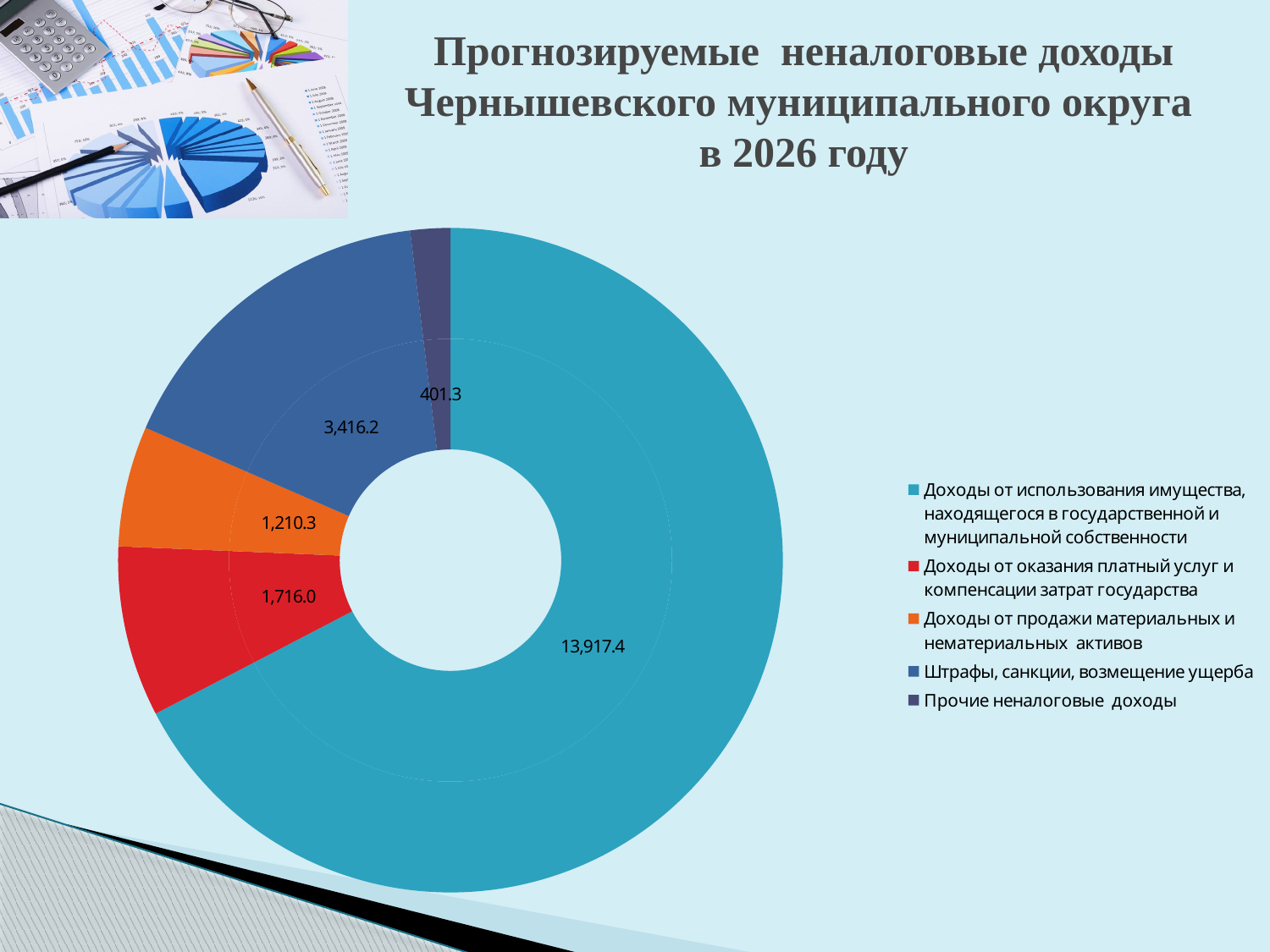
How many categories does the chart show? 5 Which is larger: «Штрафы, санкции, возмещение ущерба» or «Доходы от продажи материальных и нематериальных активов»? Штрафы, санкции, возмещение ущерба What is the value for «Доходы от использования имущества, находящегося в государственной и муниципальной собственности»? 13,917.4 What kind of chart is shown on the slide? doughnut chart Which category has the largest value? Доходы от использования имущества, находящегося в государственной и муниципальной собственности What is the difference between «Штрафы, санкции, возмещение ущерба» and «Прочие неналоговые доходы»? 3,014.9 What is the value for «Доходы от оказания платный услуг и компенсации затрат государства»? 1,716.0 What is the value for «Прочие неналоговые доходы»? 401.3 What is the value for «Штрафы, санкции, возмещение ущерба»? 3,416.2 Which category has the smallest value? Прочие неналоговые доходы What colour is the slice for «Доходы от продажи материальных и нематериальных активов»? orange What is the difference between «Доходы от оказания платный услуг и компенсации затрат государства» and «Доходы от продажи материальных и нематериальных активов»? 505.7